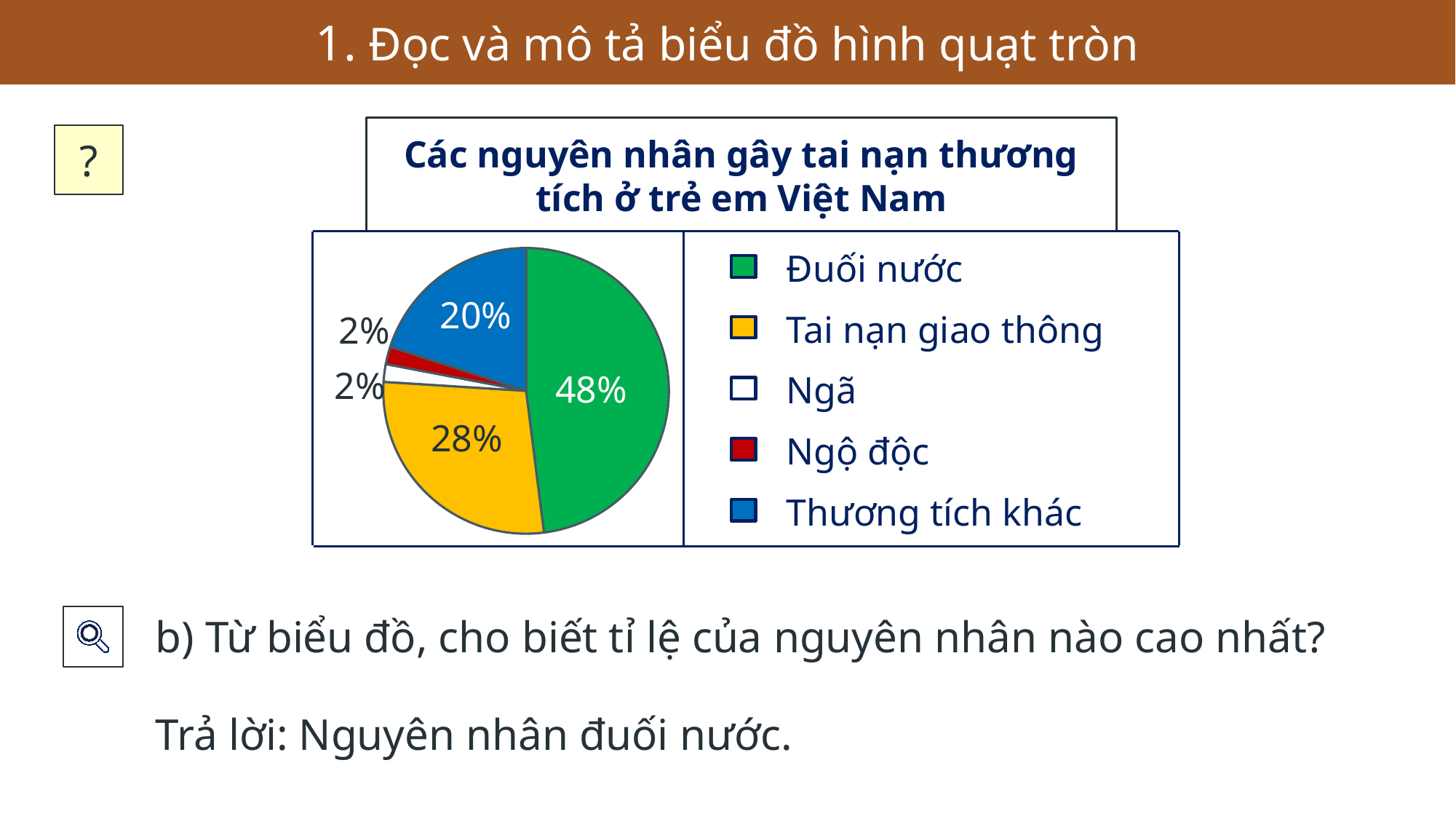
Which category has the largest share of the pie? Đuối nước What kind of chart is shown on the slide? pie chart How many categories does the legend list? 5 What is the title of the chart? Các nguyên nhân gây tai nạn thương tích ở trẻ em Việt Nam What percentage of the pie is Tai nạn giao thông? 28% What is the combined share of Ngã and Ngộ độc? 4% What percentage of the pie is Ngộ độc? 2% What is the difference between the shares of Đuối nước and Tai nạn giao thông? 20% Which is larger, the share of Tai nạn giao thông or the share of Thương tích khác? Tai nạn giao thông What percentage of the pie is Thương tích khác? 20% What colour is the slice for Đuối nước? green What percentage of the pie is Đuối nước? 48%